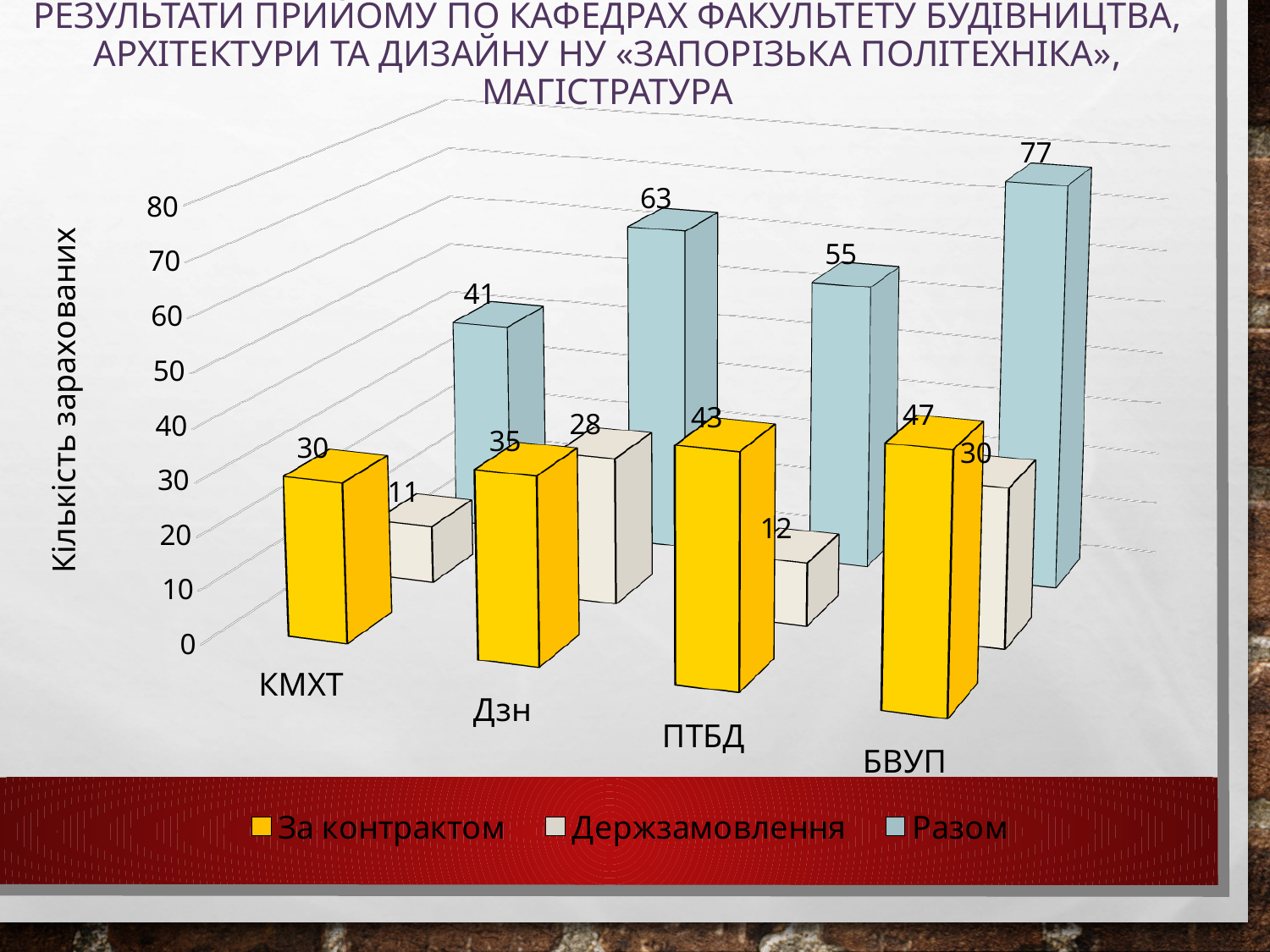
What is the value for Держзамовлення for ПТБД? 12 How many series does the legend list? 3 What is the value for За контрактом for КМХТ? 30 Which is larger: За контрактом for ПТБД or За контрактом for БВУП? За контрактом for БВУП What is the label of the vertical axis? Кількість зарахованих What is the difference between the Разом values for Дзн and ПТБД? 8 Which category has the highest value for Разом? БВУП Which category has the lowest value for Держзамовлення? КМХТ What is the value for Разом for БВУП? 77 How many categories are shown on the x axis? 4 What kind of chart is shown on the slide? Bar chart What is the value for Держзамовлення for Дзн? 28